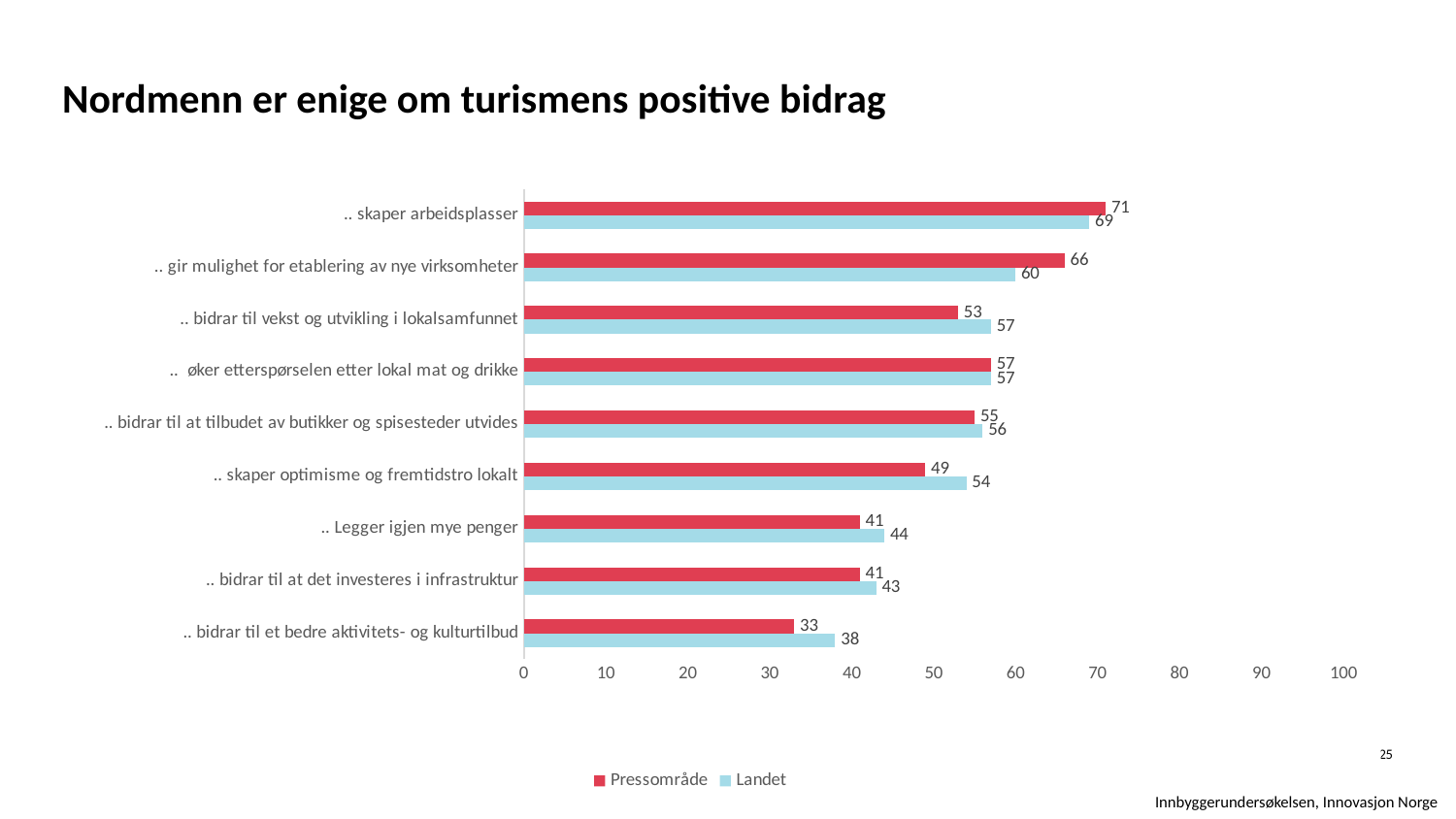
What kind of chart is shown on the slide? Bar chart Which category has the highest Pressområde value? .. skaper arbeidsplasser What is the Landet value for ".. skaper optimisme og fremtidstro lokalt"? 54 How many series does the legend list? 2 How many categories are shown on the chart? 9 Which category has the lowest Landet value? .. bidrar til et bedre aktivitets- og kulturtilbud For ".. bidrar til vekst og utvikling i lokalsamfunnet", which series has the larger value, Pressområde or Landet? Landet Which colour represents the Landet series? Light blue What is the Pressområde value for ".. skaper arbeidsplasser"? 71 What is the title of the slide? Nordmenn er enige om turismens positive bidrag What is the Landet value for ".. bidrar til et bedre aktivitets- og kulturtilbud"? 38 What is the difference between the Pressområde and Landet values for ".. gir mulighet for etablering av nye virksomheter"? 6